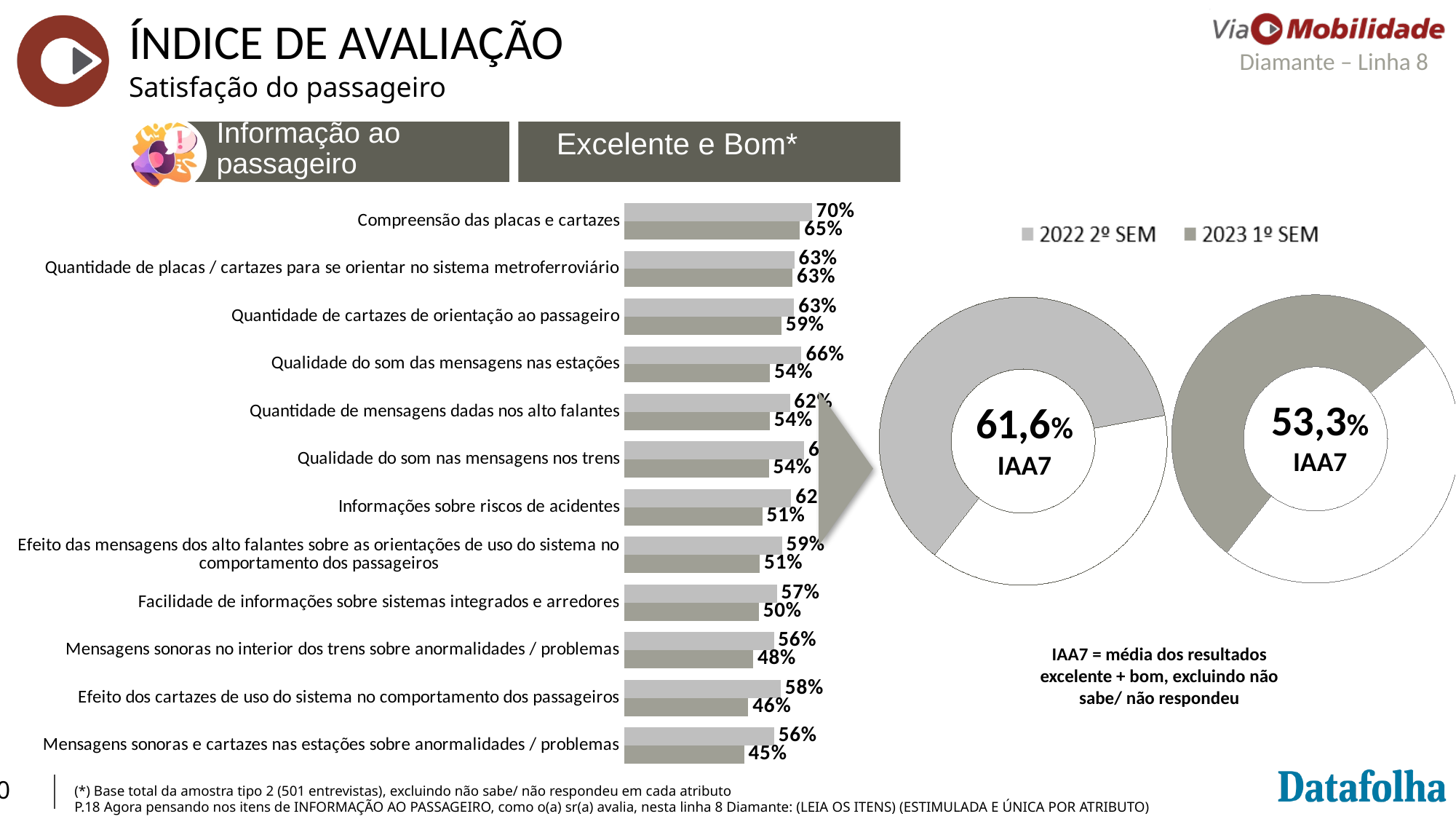
What IAA7 value is shown in the right donut chart (2023 1º SEM)? 53,3% In the bar chart, which attribute has the lowest 2023 1º SEM value? Mensagens sonoras e cartazes nas estações sobre anormalidades / problemas In the bar chart, what is the difference between the 2022 2º SEM and 2023 1º SEM values for 'Efeito dos cartazes de uso do sistema no comportamento dos passageiros'? 12% How many attributes (categories) are shown in the bar chart? 12 What kind of chart is used to show the 'Excelente e Bom*' results by attribute? bar chart In the bar chart, for 'Qualidade do som das mensagens nas estações', which is larger: the 2022 2º SEM value or the 2023 1º SEM value? 2022 2º SEM In the bar chart, what is the 2023 1º SEM value for 'Qualidade do som das mensagens nas estações'? 54% What IAA7 value is shown in the left donut chart (2022 2º SEM)? 61,6% In the bar chart, what is the 2023 1º SEM value for 'Mensagens sonoras e cartazes nas estações sobre anormalidades / problemas'? 45% How many series does the legend of the bar chart list? 2 In the bar chart, what is the 2022 2º SEM value for 'Compreensão das placas e cartazes'? 70% In the bar chart, which attribute has the highest 2022 2º SEM value? Compreensão das placas e cartazes